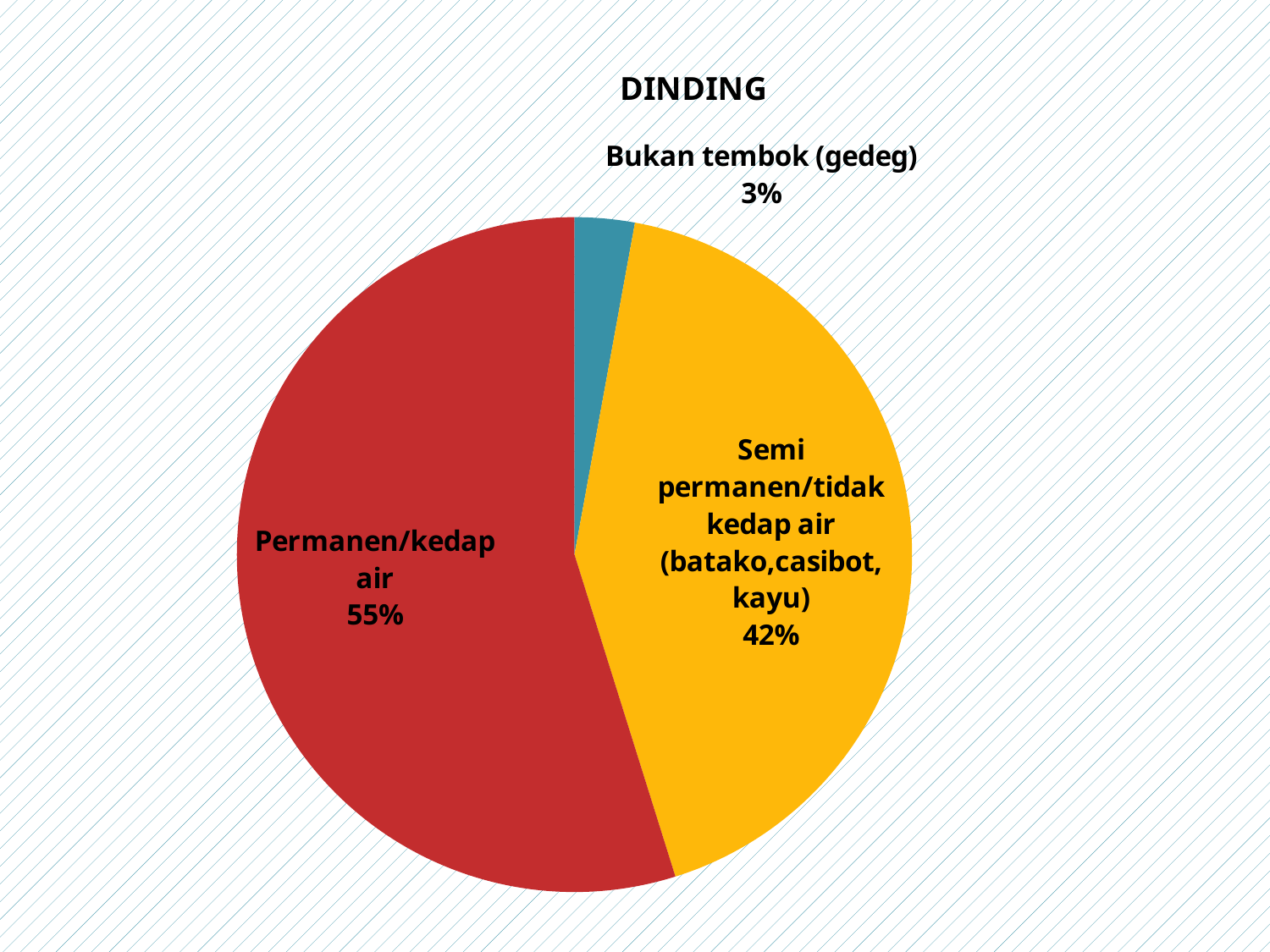
How many categories are shown in the pie chart? 3 What share of the pie does Semi permanen/tidak kedap air (batako,casibot, kayu) have? 42% What is the difference in percentage points between Semi permanen/tidak kedap air (batako,casibot, kayu) and Bukan tembok (gedeg)? 39 percentage points Which category has the smallest share of the pie? Bukan tembok (gedeg) What type of chart is shown on the slide? pie chart What is the title of the chart? DINDING What share of the pie does Permanen/kedap air have? 55% What share of the pie does Bukan tembok (gedeg) have? 3% Which is larger, the share for Permanen/kedap air or the share for Semi permanen/tidak kedap air (batako,casibot, kayu)? Permanen/kedap air What is the difference in percentage points between Permanen/kedap air and Semi permanen/tidak kedap air (batako,casibot, kayu)? 13 percentage points What colour is the slice for Bukan tembok (gedeg)? blue Which category has the largest share of the pie? Permanen/kedap air